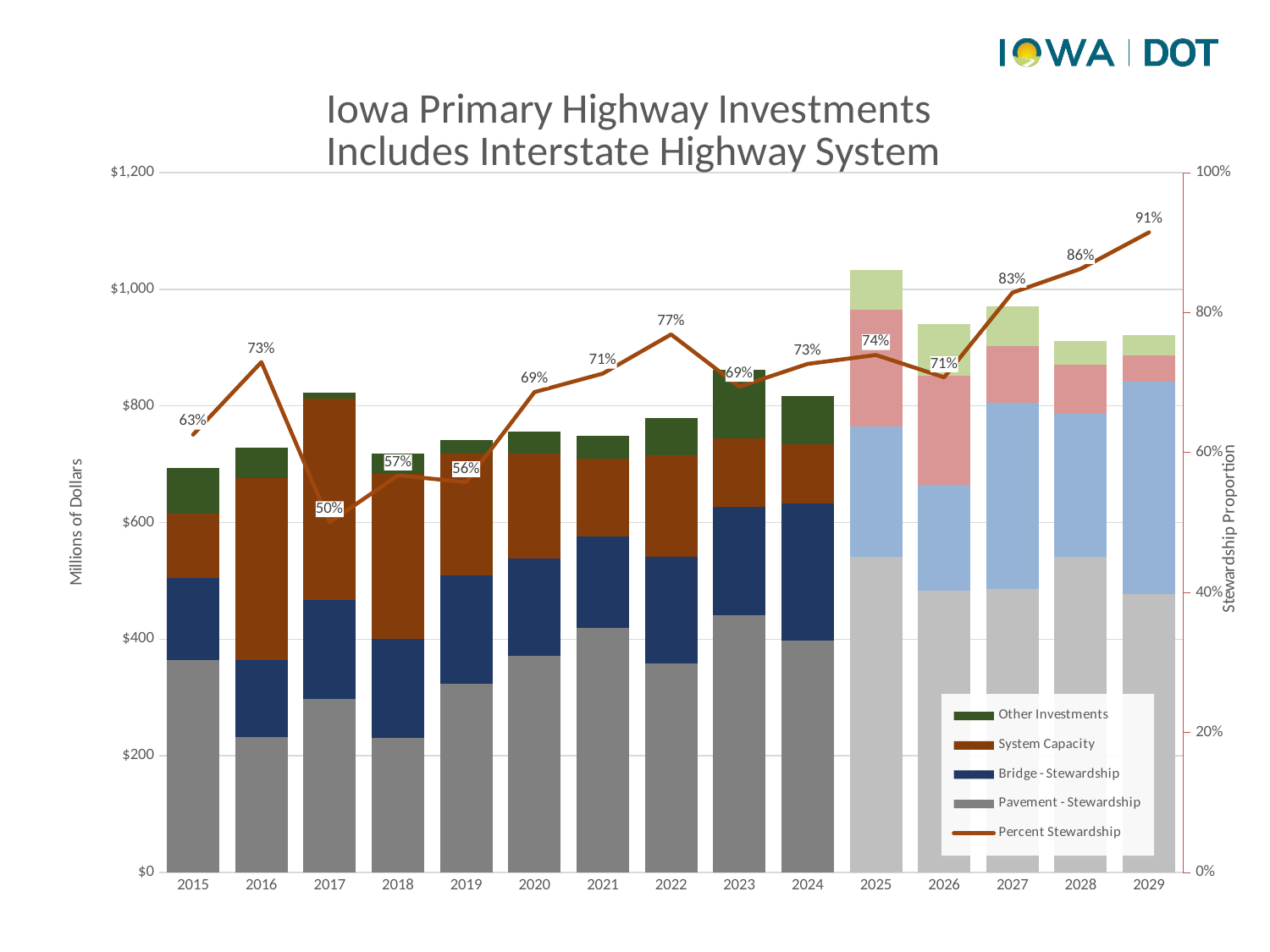
How many series does the legend list? 5 Which year has the highest Percent Stewardship? 2029 By how many percentage points does Percent Stewardship in 2029 exceed that in 2015? 28 percentage points What is the Percent Stewardship value for 2022? 77% Which year has the lowest Percent Stewardship? 2017 Which year has the higher Percent Stewardship, 2016 or 2017? 2016 Is the total investment bar for 2025 greater or less than $1,000 million? greater What is the Percent Stewardship value for 2029? 91% What is the Percent Stewardship value for 2017? 50% What kind of chart is this? A combination stacked bar and line chart Is the total investment bar for 2015 greater or less than $800 million? less How many years are shown on the x axis? 15